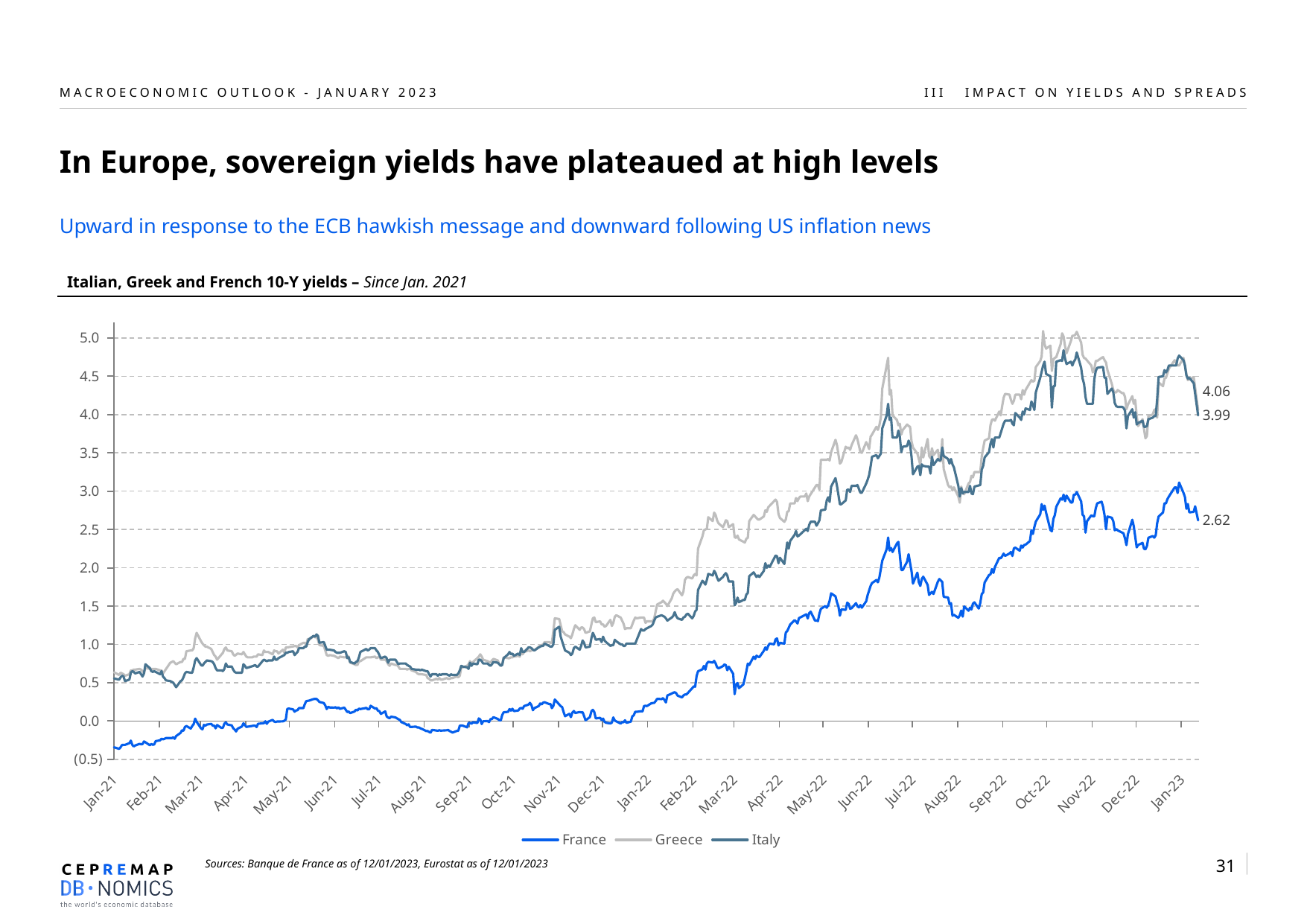
Does the France yield rise or fall overall from Jan-21 to Jan-23? rise What is the difference between the latest labelled values for Greece and France? 1.44 What kind of chart is shown on the slide? line chart How many series does the legend list? 3 Is the value for France in Jan-21 greater or less than 0.0? less Is the value for Italy in Jan-21 greater or less than 1.0? less At the right end of the chart, which is larger: the France value or the Italy value? Italy What is the latest value labelled for Italy at the right end of the chart? 3.99 What is the title of the chart? Italian, Greek and French 10-Y yields – Since Jan. 2021 Which series has the lowest value at the right end of the chart? France What is the latest value labelled for Greece at the right end of the chart? 4.06 What is the latest value labelled for France at the right end of the chart? 2.62